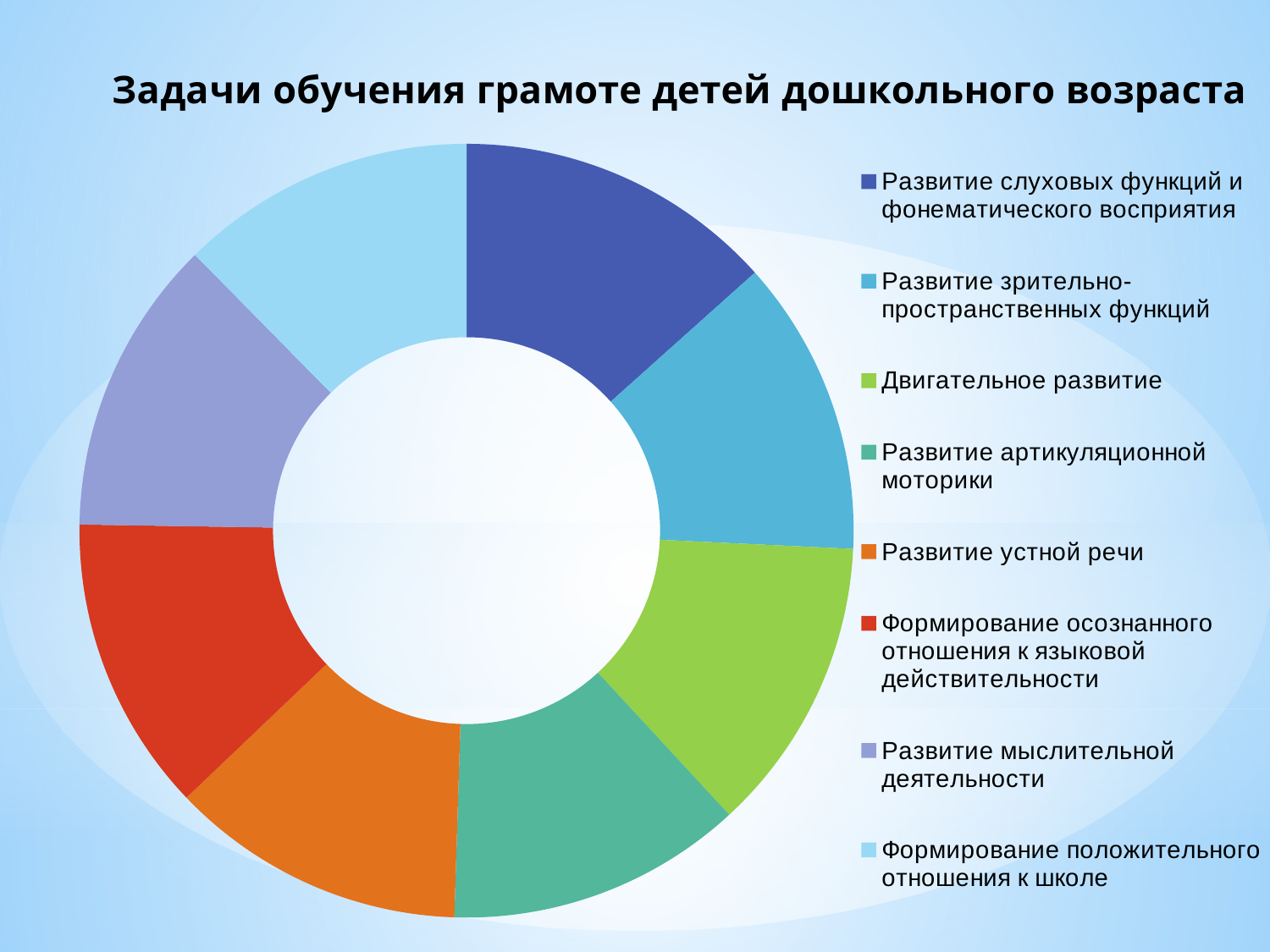
What kind of chart is shown on the slide? Doughnut chart Which legend entry is shown in orange on the chart? Развитие устной речи Which legend entry is shown in red on the chart? Формирование осознанного отношения к языковой действительности Which category is listed last in the chart's legend? Формирование положительного отношения к школе How many entries does the legend of the chart list? 8 How many segments does the doughnut chart have? 8 Which category is listed first in the chart's legend? Развитие слуховых функций и фонематического восприятия What is the title of the slide with the doughnut chart? Задачи обучения грамоте детей дошкольного возраста